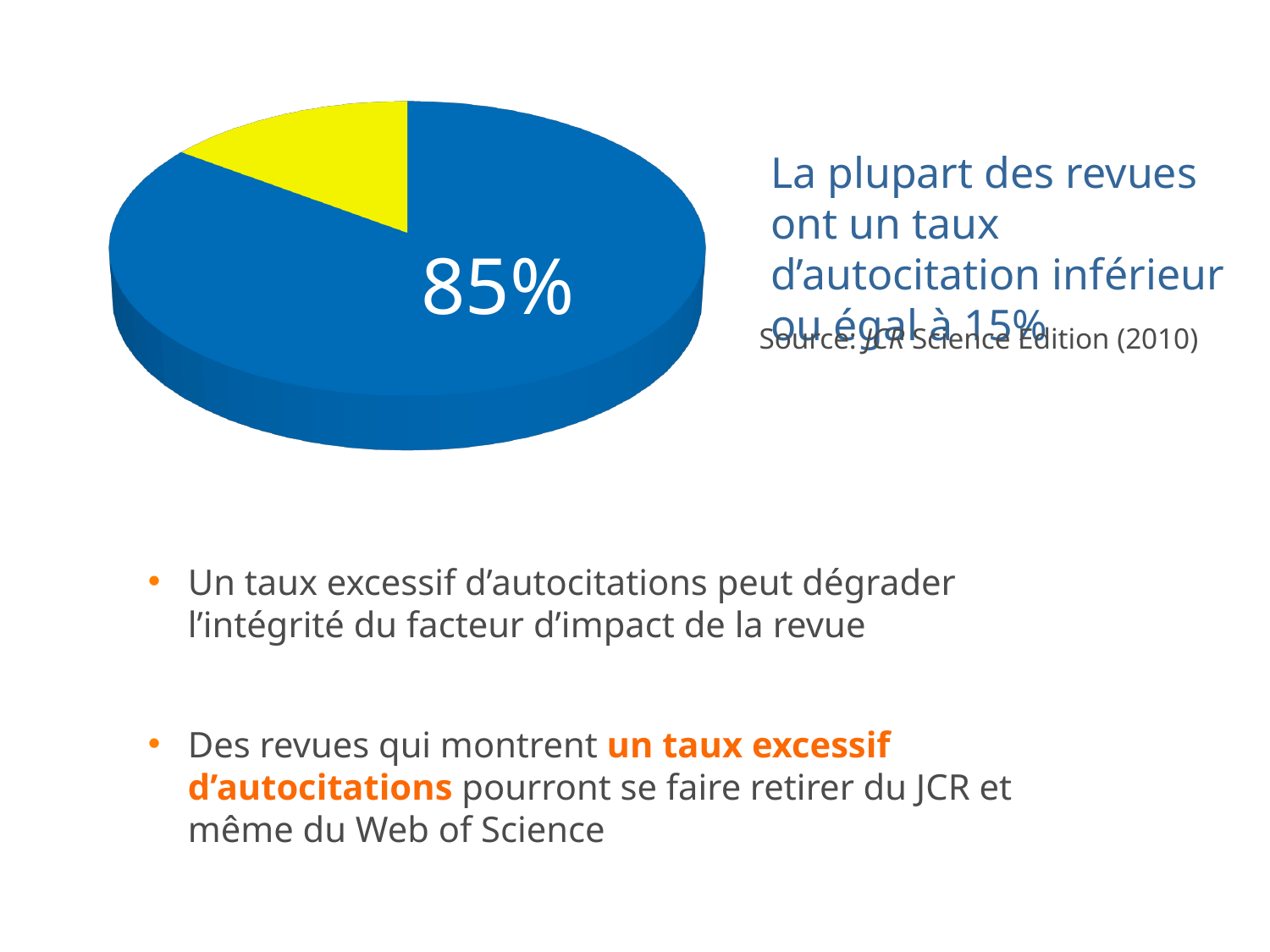
What share of the pie does the blue slice represent? 85% What value is printed on the blue slice of the pie chart? 85% Is the pie chart drawn in 3D or flat 2D? 3D What colour is the smallest slice of the pie chart? yellow What colour is the largest slice of the pie chart? blue How many slices does the pie chart have? 2 Does the pie chart display a legend? No Which slice of the pie chart is larger, the blue one or the yellow one? blue What kind of chart is shown on the slide? pie chart